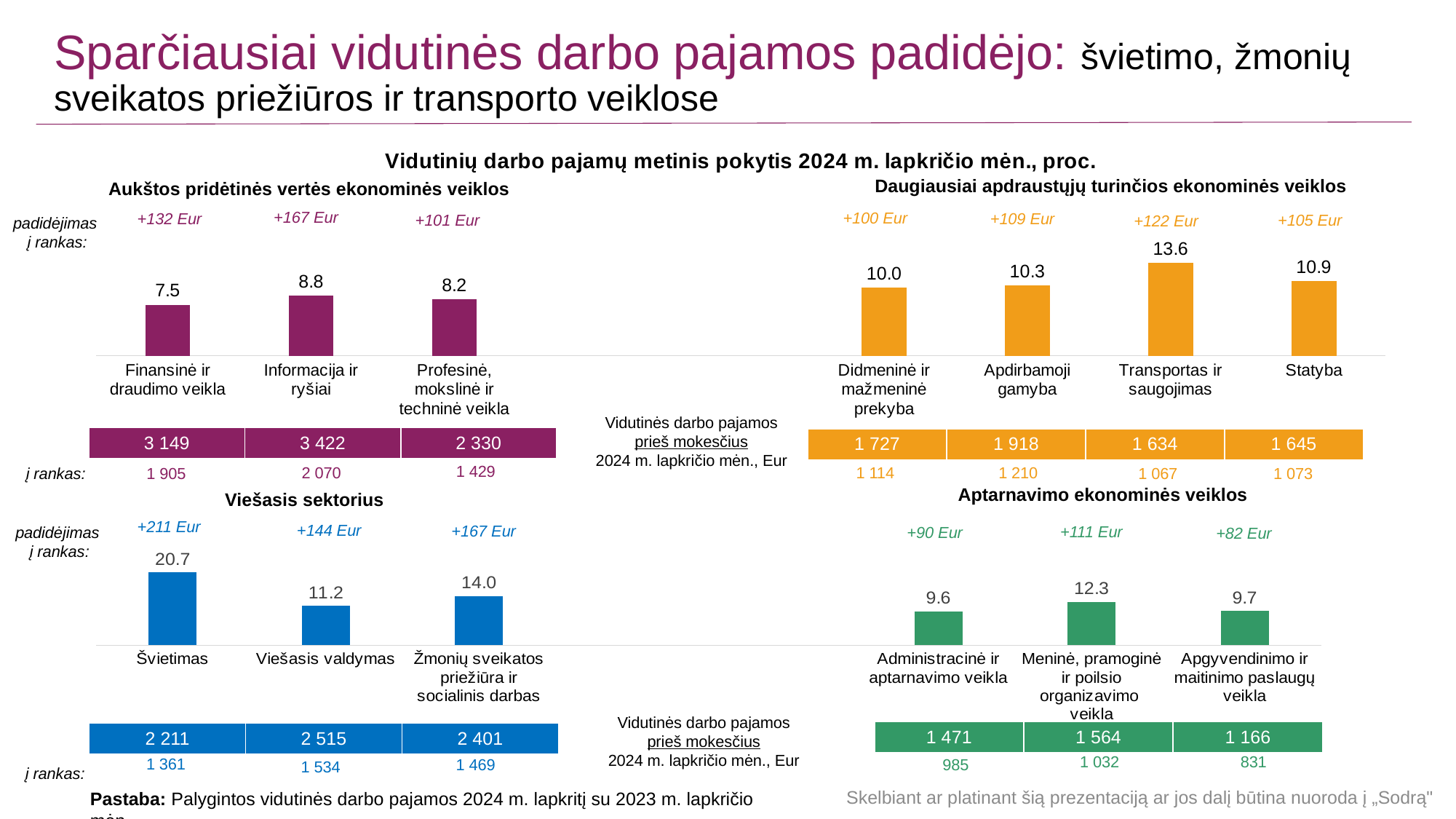
In the "Daugiausiai apdraustųjų turinčios ekonominės veiklos" chart, what is the value for Apdirbamoji gamyba? 10.3 What kind of chart is the "Viešasis sektorius" chart? Bar chart In the "Viešasis sektorius" chart, which is larger: the value for Viešasis valdymas or the value for Žmonių sveikatos priežiūra ir socialinis darbas? Žmonių sveikatos priežiūra ir socialinis darbas In the "Daugiausiai apdraustųjų turinčios ekonominės veiklos" chart, which category has the highest value? Transportas ir saugojimas In the "Aptarnavimo ekonominės veiklos" chart, what is the value for Meninė, pramoginė ir poilsio organizavimo veikla? 12.3 In the "Viešasis sektorius" chart, what is the difference between the values for Švietimas and Viešasis valdymas? 9.5 In the "Aptarnavimo ekonominės veiklos" chart, which category has the lowest value? Administracinė ir aptarnavimo veikla What colour are the bars in the "Aptarnavimo ekonominės veiklos" chart? Green In the "Daugiausiai apdraustųjų turinčios ekonominės veiklos" chart, how many categories are shown? 4 In the "Aukštos pridėtinės vertės ekonominės veiklos" chart, which category has the lowest value? Finansinė ir draudimo veikla In the "Viešasis sektorius" chart, what is the value for Švietimas? 20.7 In the "Aukštos pridėtinės vertės ekonominės veiklos" chart, what is the value for Informacija ir ryšiai? 8.8